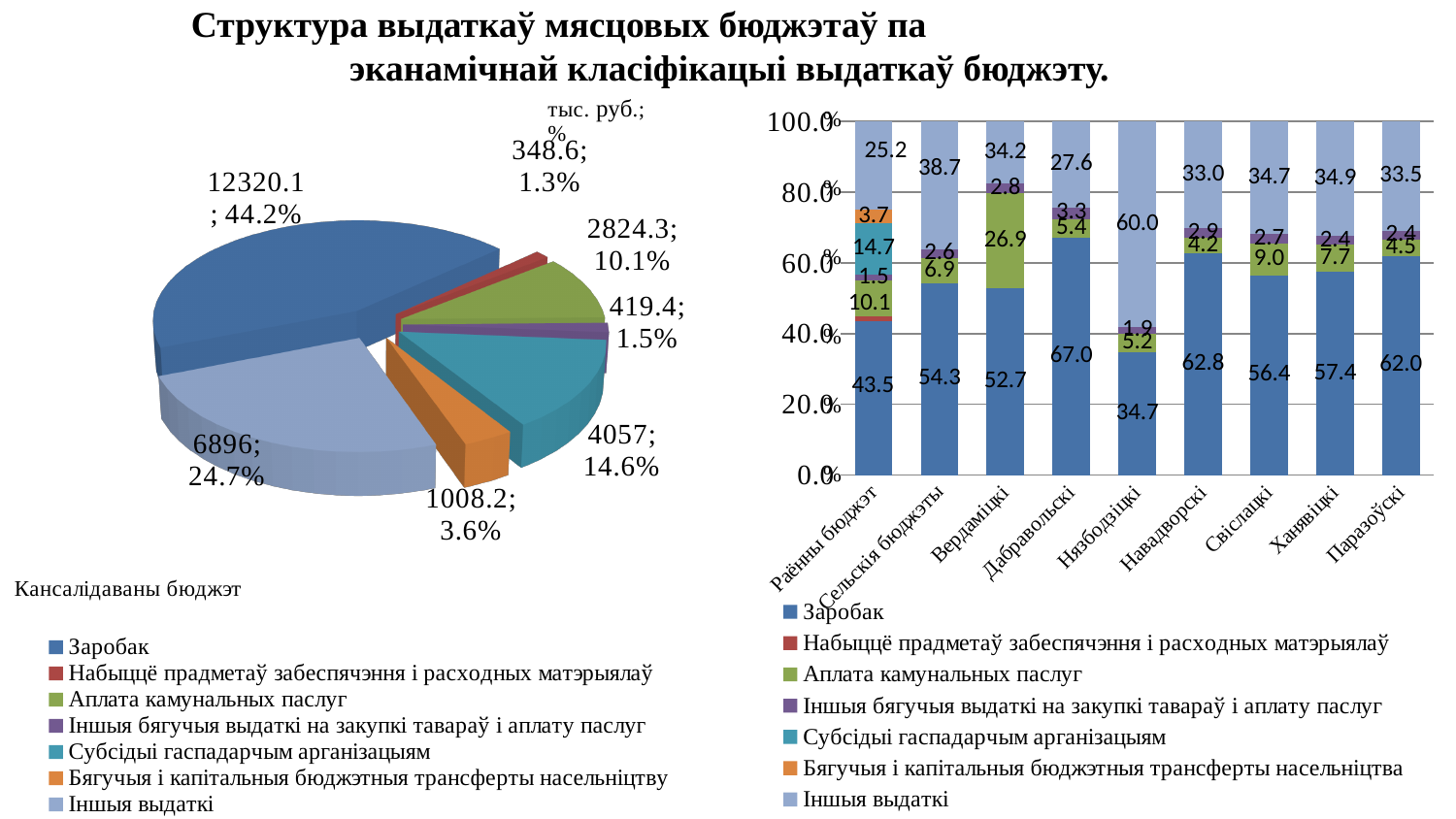
In the pie chart on the left, what share does the Іншыя выдаткі slice have? 24.7% In the stacked bar chart on the right, what is the Заробак value for Нязбодзіцкі? 34.7 In the stacked bar chart on the right, how many series does the legend list? 7 In the stacked bar chart on the right, how many categories are shown on the x axis? 9 In the pie chart on the left, how many slices are there? 7 In the stacked bar chart on the right, which category has the highest Заробак value? Дабравольскі In the stacked bar chart on the right, what is the difference between the Заробак values for Навадворскі and Раённы бюджэт? 19.3 In the pie chart on the left, what is the value shown for Субсідыі гаспадарчым арганізацыям? 4057; 14.6% What type of chart is shown on the right side of the slide? Stacked bar chart In the pie chart on the left, what value and share are shown for the Заробак slice? 12320.1; 44.2% In the stacked bar chart on the right, what is the Іншыя выдаткі value for Нязбодзіцкі? 60.0 In the pie chart on the left, which category has the smallest share? Набыццё прадметаў забеспячэння і расходных матэрыялаў